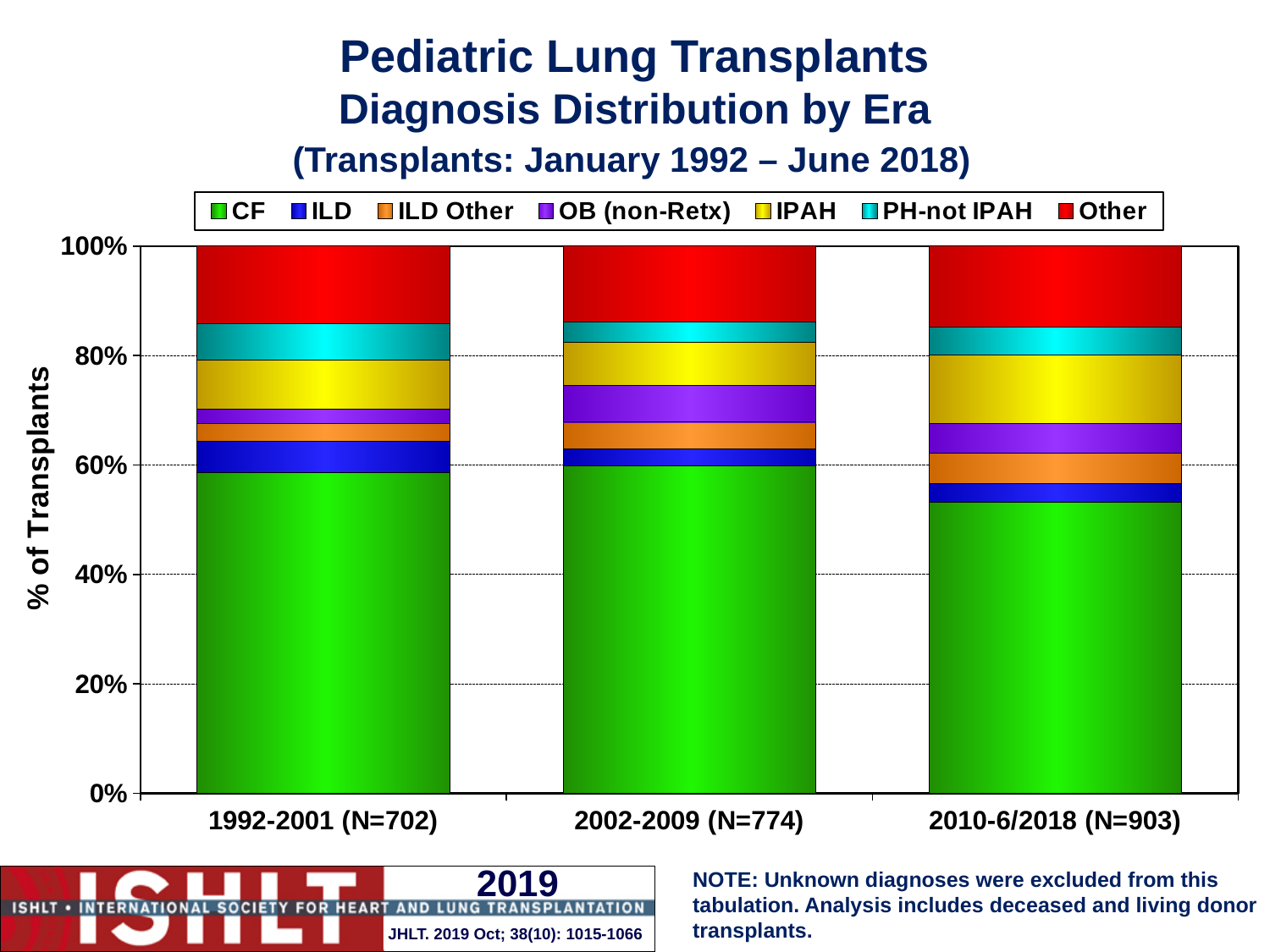
How many diagnosis series does the legend list? 7 What does each stacked bar total on the y axis? 100% Which era has the smallest OB (non-Retx) share of transplants? 1992-2001 (N=702) Which era has the smallest CF share of transplants? 2010-6/2018 (N=903) What type of chart is shown on the slide? Stacked bar chart What is the N for the 2010-6/2018 era? 903 What is the N for the 1992-2001 era? 702 Which era has the largest ILD share of transplants? 1992-2001 (N=702) What is the N for the 2002-2009 era? 774 Is the CF share of transplants in the 2010-6/2018 era greater or less than 60%? less Which is larger: the CF share in 2002-2009 or the CF share in 2010-6/2018? 2002-2009 How many eras (bars) are shown on the x axis? 3